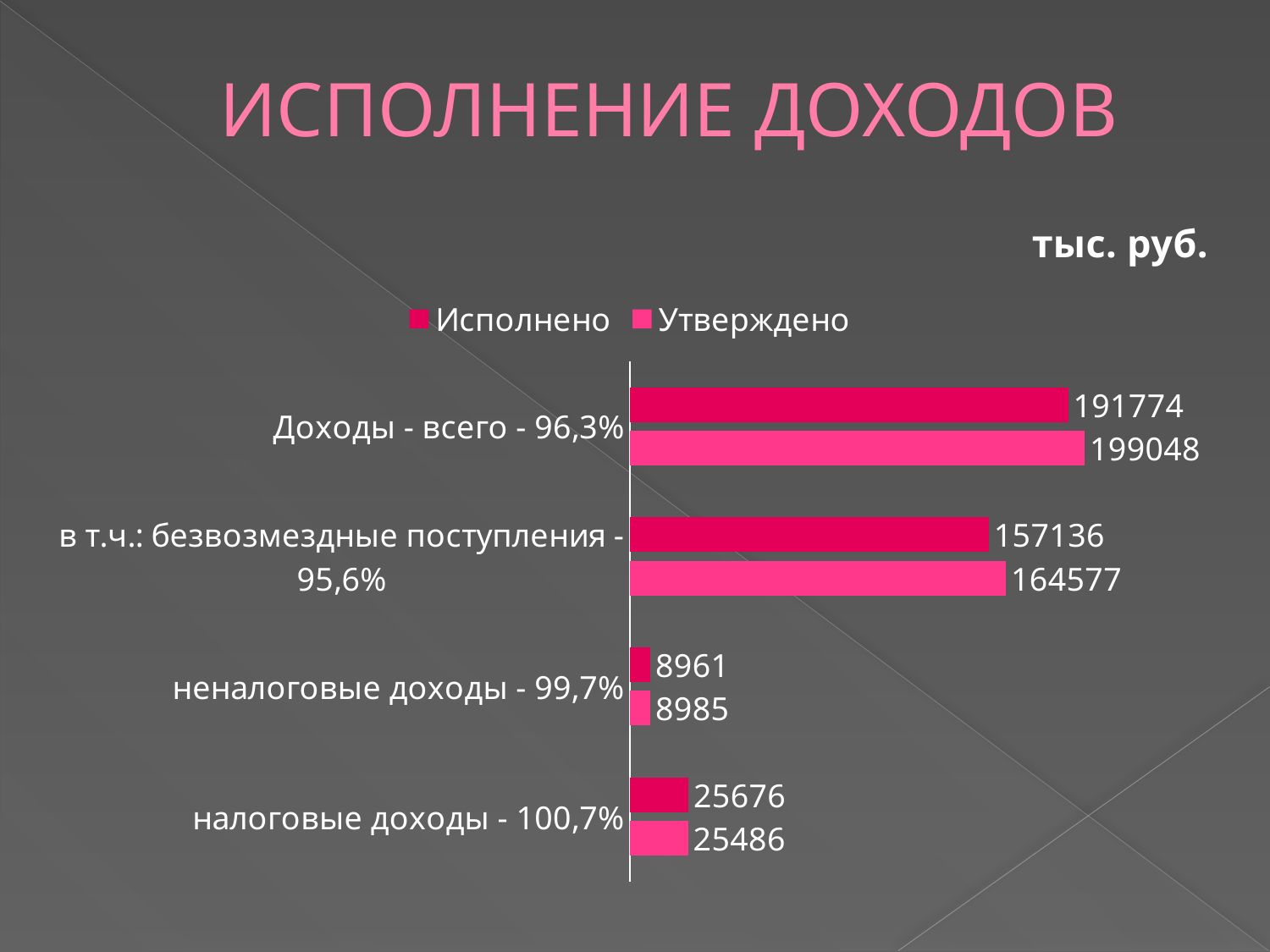
What is the Исполнено value for "Доходы - всего - 96,3%"? 191774 What kind of chart is shown on the slide? Bar chart What is the Утверждено value for "в т.ч.: безвозмездные поступления - 95,6%"? 164577 What is the Утверждено value for "неналоговые доходы - 99,7%"? 8985 What is the Исполнено value for "налоговые доходы - 100,7%"? 25676 How many series does the legend list? 2 For "налоговые доходы - 100,7%", which is larger: the Исполнено value or the Утверждено value? Исполнено Which category has the lowest Исполнено value? неналоговые доходы - 99,7% How many categories are shown in the chart? 4 Which category has the highest Утверждено value? Доходы - всего - 96,3% What is the difference between the Исполнено and Утверждено values for "налоговые доходы - 100,7%"? 190 What is the difference between the Утверждено and Исполнено values for "Доходы - всего - 96,3%"? 7274